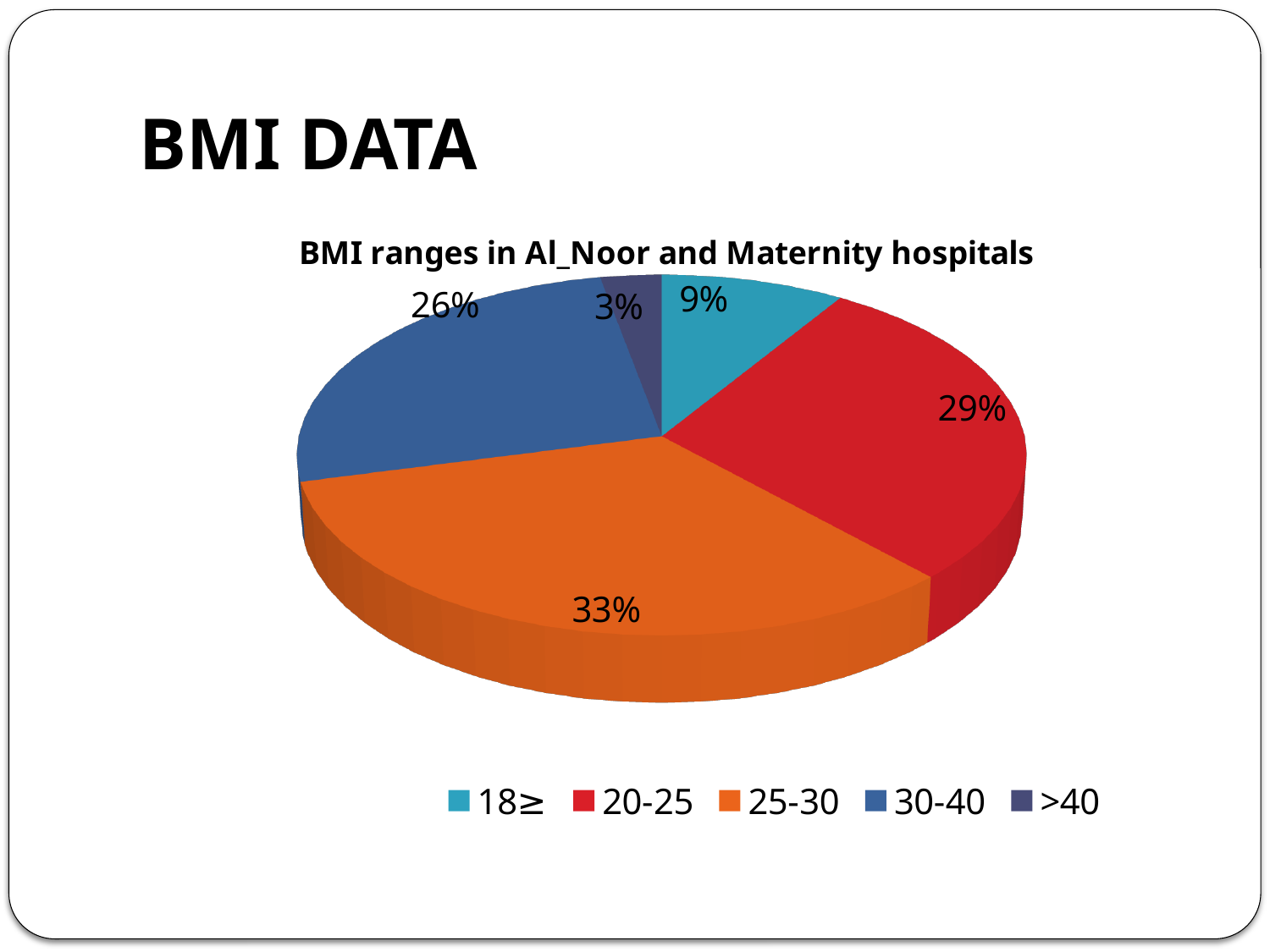
Which BMI range has the largest share of the pie? 25-30 What is the difference in percentage points between the 25-30 and 20-25 BMI ranges? 4 What percentage is shown for the 20-25 BMI range? 29% What percentage of the pie does the 25-30 BMI range represent? 33% What type of chart is shown on the slide? Pie chart Which share is larger, the 30-40 range or the 18≥ range? 30-40 How many BMI ranges are listed in the legend? 5 What percentage is shown for the 18≥ BMI range? 9% What percentage is shown for the 30-40 BMI range? 26% What is the title of the chart? BMI ranges in Al_Noor and Maternity hospitals What percentage is shown for the >40 BMI range? 3% Which BMI range has the smallest share of the pie? >40